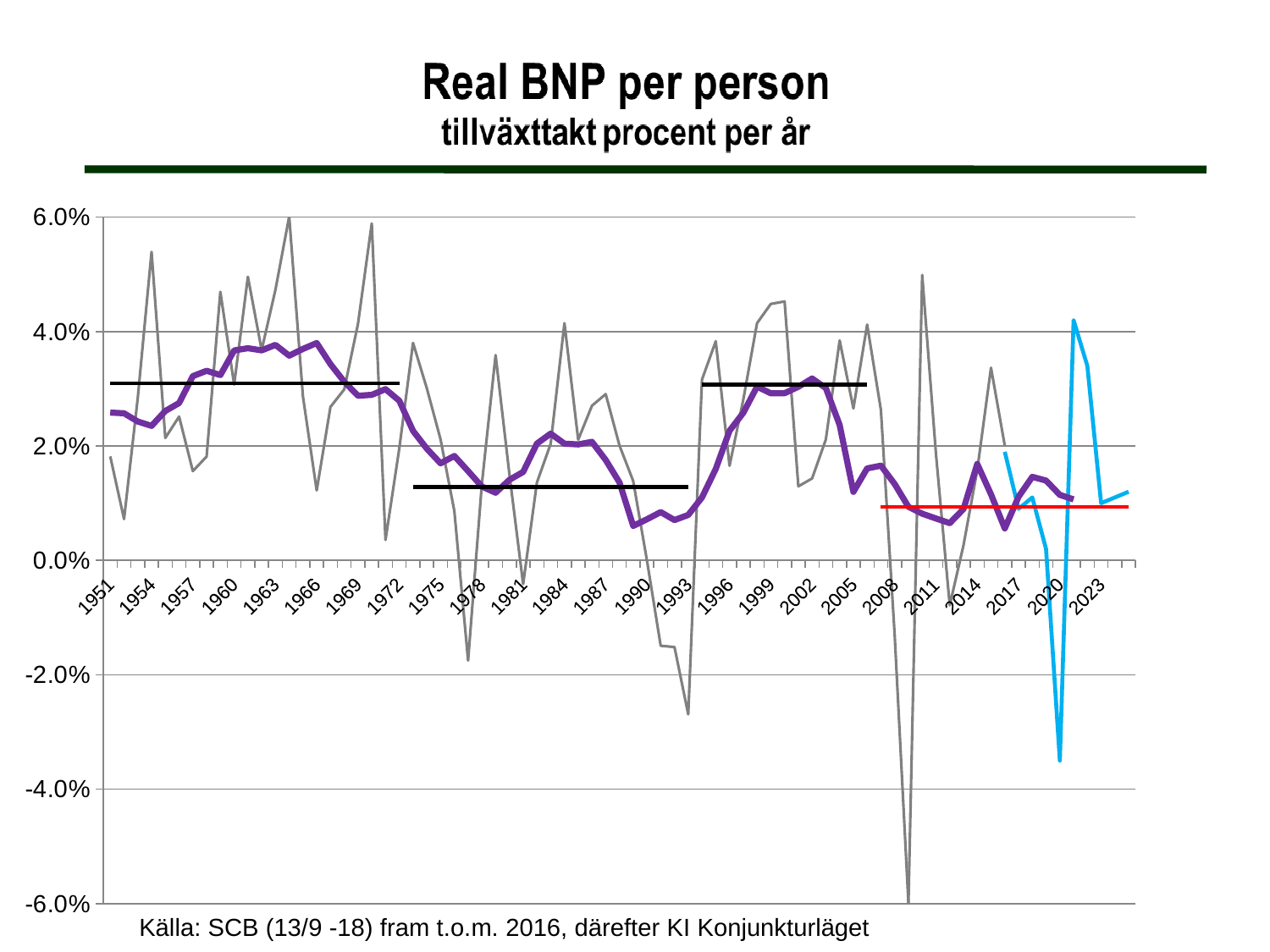
Is the value of the purple line around 1963 greater or less than 2.0%? greater Is the value of the grey line around 2009 greater or less than -4.0%? less What is the title of the chart? Real BNP per person tillväxttakt procent per år What kind of chart is shown on the slide? line chart How many year labels are shown on the horizontal axis? 25 Is the value of the blue line around 2021 greater or less than 2.0%? greater Does the purple line rise or fall between 1966 and 1990? fall Does the purple line rise or fall between 1951 and 1963? rise What is the highest value shown on the vertical axis? 6.0%